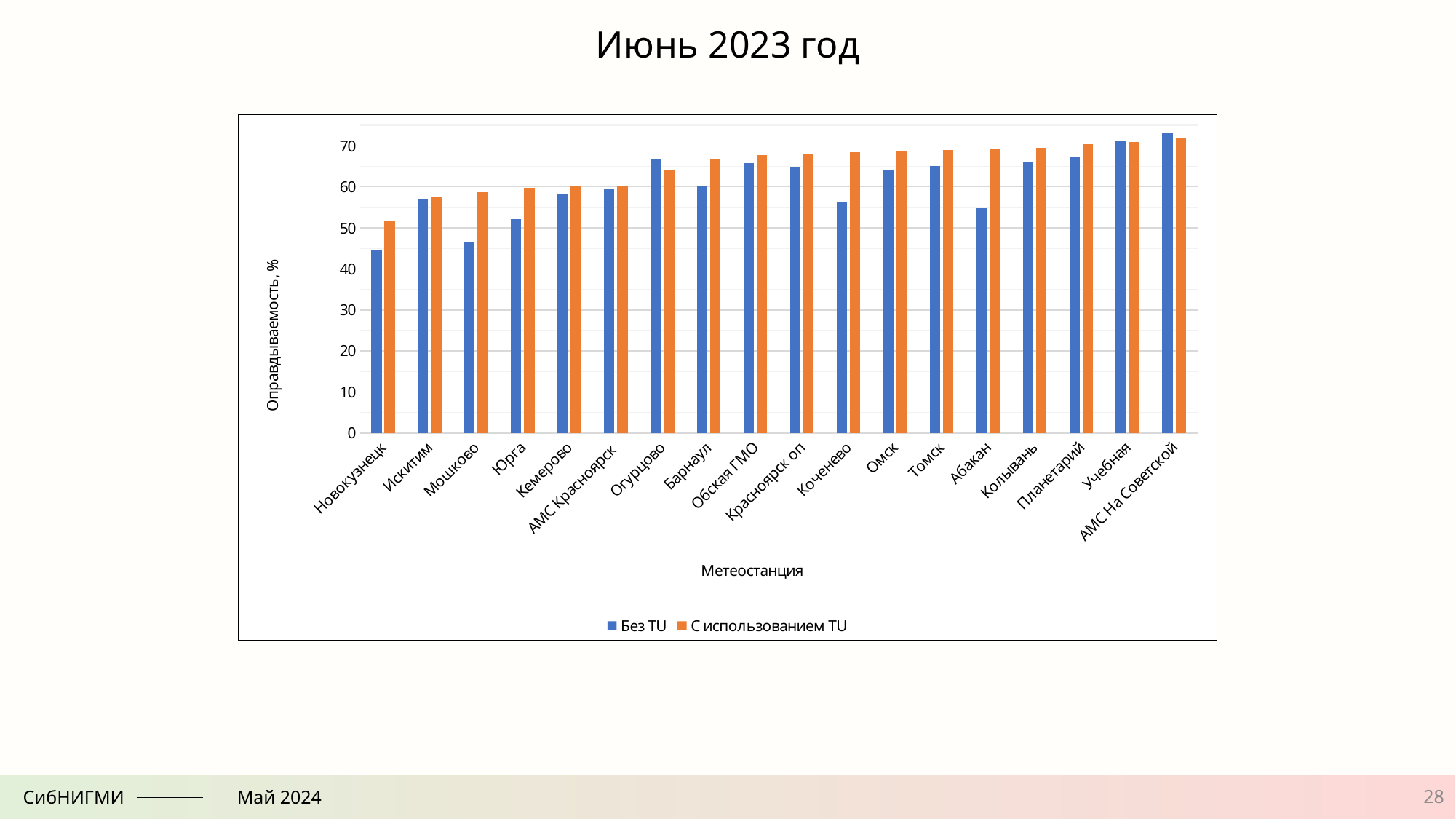
What kind of chart is shown on the slide? bar chart How many series does the legend list? 2 Which station has the lowest value for the 'Без TU' series? Новокузнецк Which station has the highest value for the 'Без TU' series? АМС На Советской What is the title of the slide above the chart? Июнь 2023 год Is the 'Без TU' value for Коченево greater or less than 60? less Is the 'Без TU' value for Новокузнецк greater or less than 50? less What is the label of the y axis? Оправдываемость, % Do the 'С использованием TU' values generally rise or fall from left to right along the x axis? rise Is the 'Без TU' value for Абакан greater or less than 50? greater For Огурцово, which series has the larger value: 'Без TU' or 'С использованием TU'? Без TU How many meteorological stations (categories) are shown on the x axis? 18